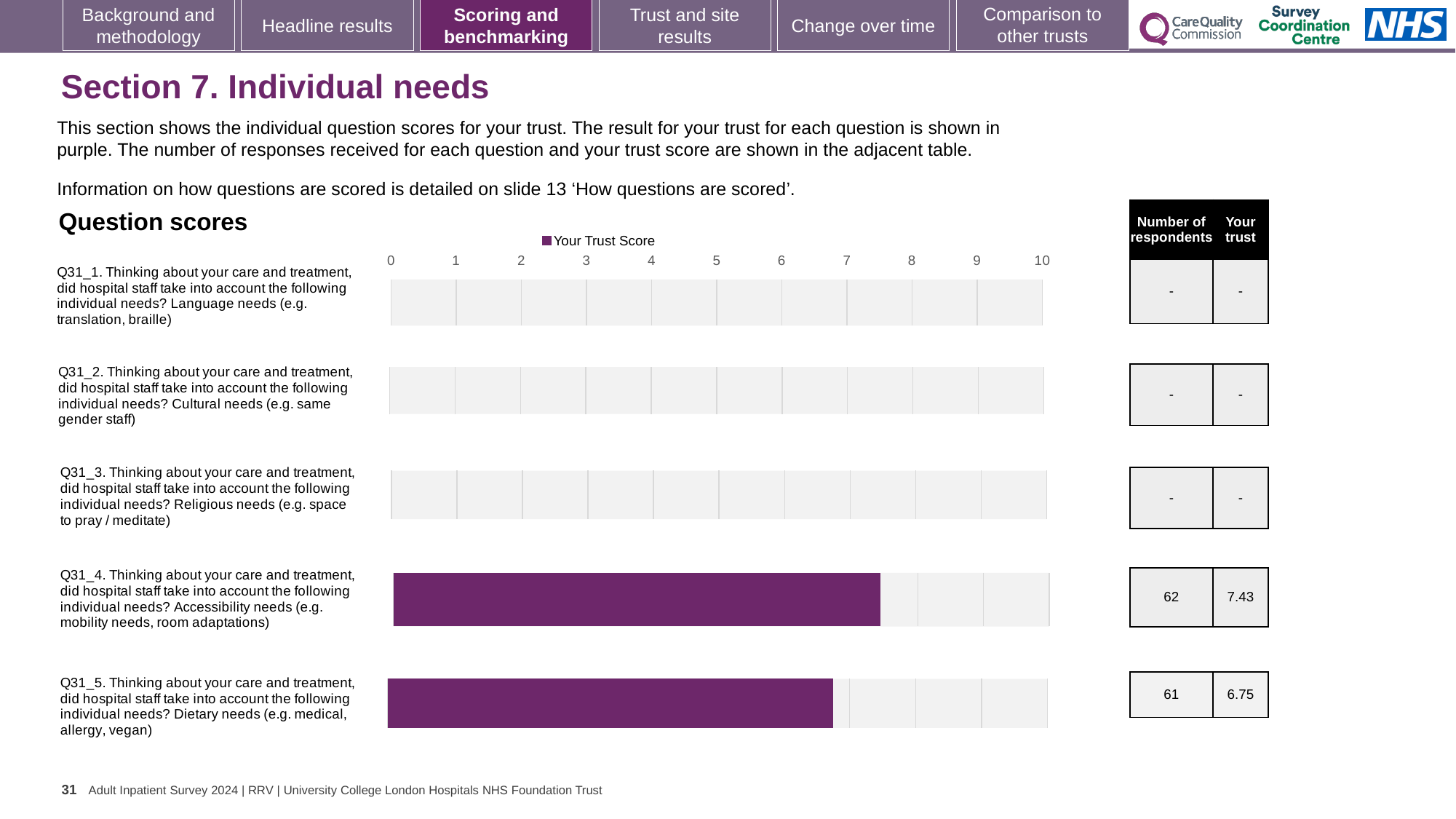
What is the trust score for Q31_4 (Accessibility needs)? 7.43 Is the trust score for Q31_5 (Dietary needs) greater or less than 7? less How many questions are listed in the Question scores chart? 5 What is the trust score for Q31_5 (Dietary needs)? 6.75 What is the maximum value shown on the x axis of the Question scores chart? 10 How many respondents answered Q31_4 (Accessibility needs)? 62 What is the difference between the trust scores for Q31_4 (Accessibility needs) and Q31_5 (Dietary needs)? 0.68 How many series does the legend of the Question scores chart list? 1 Is the trust score for Q31_4 (Accessibility needs) greater or less than 7? greater Which question has the higher trust score, Q31_4 (Accessibility needs) or Q31_5 (Dietary needs)? Q31_4 (Accessibility needs) What kind of chart is used to show the question scores? Bar chart How many respondents answered Q31_5 (Dietary needs)? 61